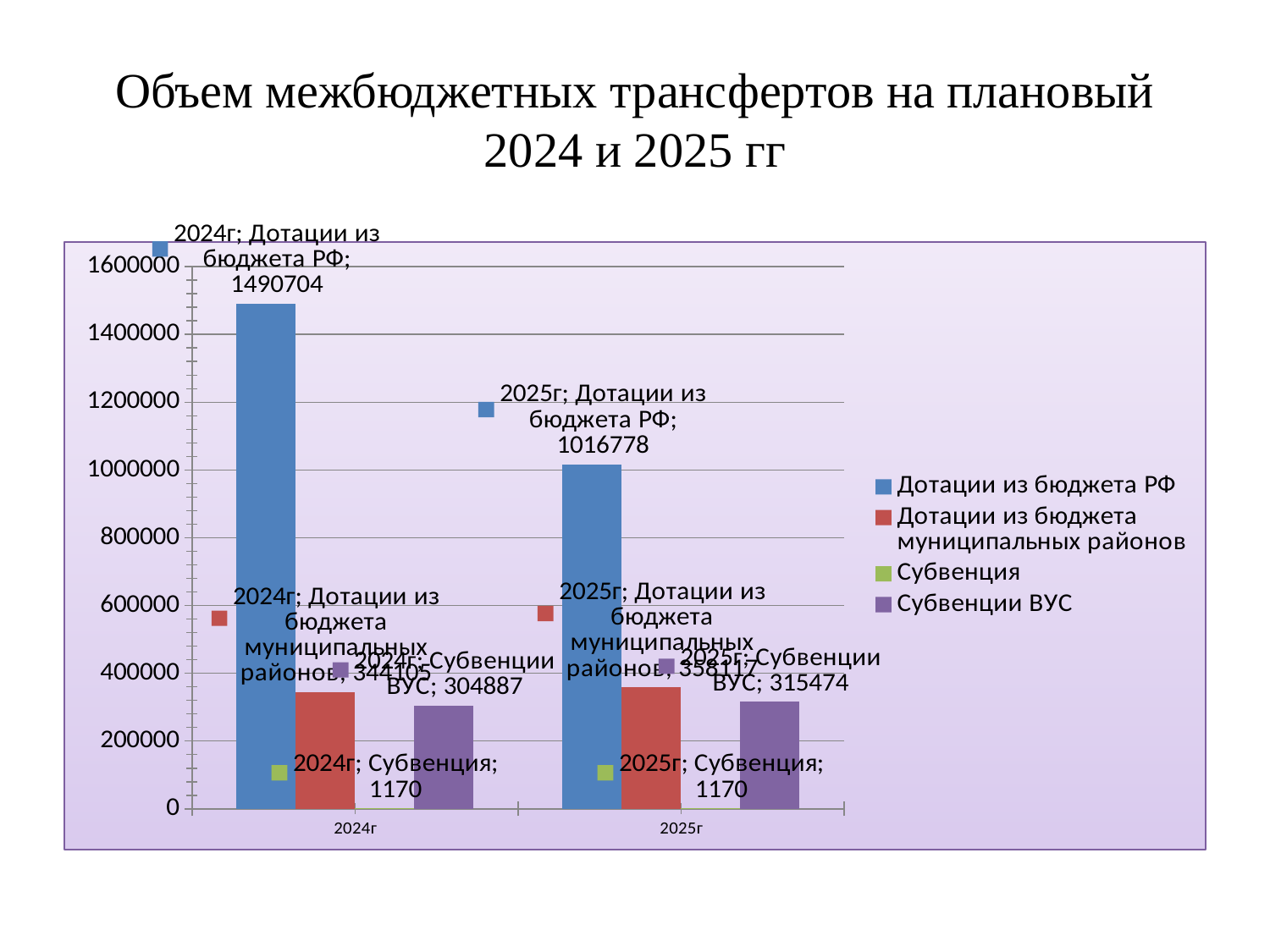
What is the difference between Субвенции ВУС in 2025г and in 2024г? 10587 What is the value of Дотации из бюджета РФ for 2025г? 1016778 What is the value of Дотации из бюджета РФ for 2024г? 1490704 How many series does the legend list? 4 Which series has the highest value in 2025г? Дотации из бюджета РФ What is the value of Субвенции ВУС for 2024г? 304887 By how much does Дотации из бюджета РФ in 2024г exceed Дотации из бюджета РФ in 2025г? 473926 What is the value of Субвенции ВУС for 2025г? 315474 What kind of chart is shown on the slide? bar chart What is the value of Субвенция for 2025г? 1170 Is Субвенции ВУС larger in 2024г or in 2025г? 2025г Is the value of Дотации из бюджета муниципальных районов for 2024г greater or less than 400000? less